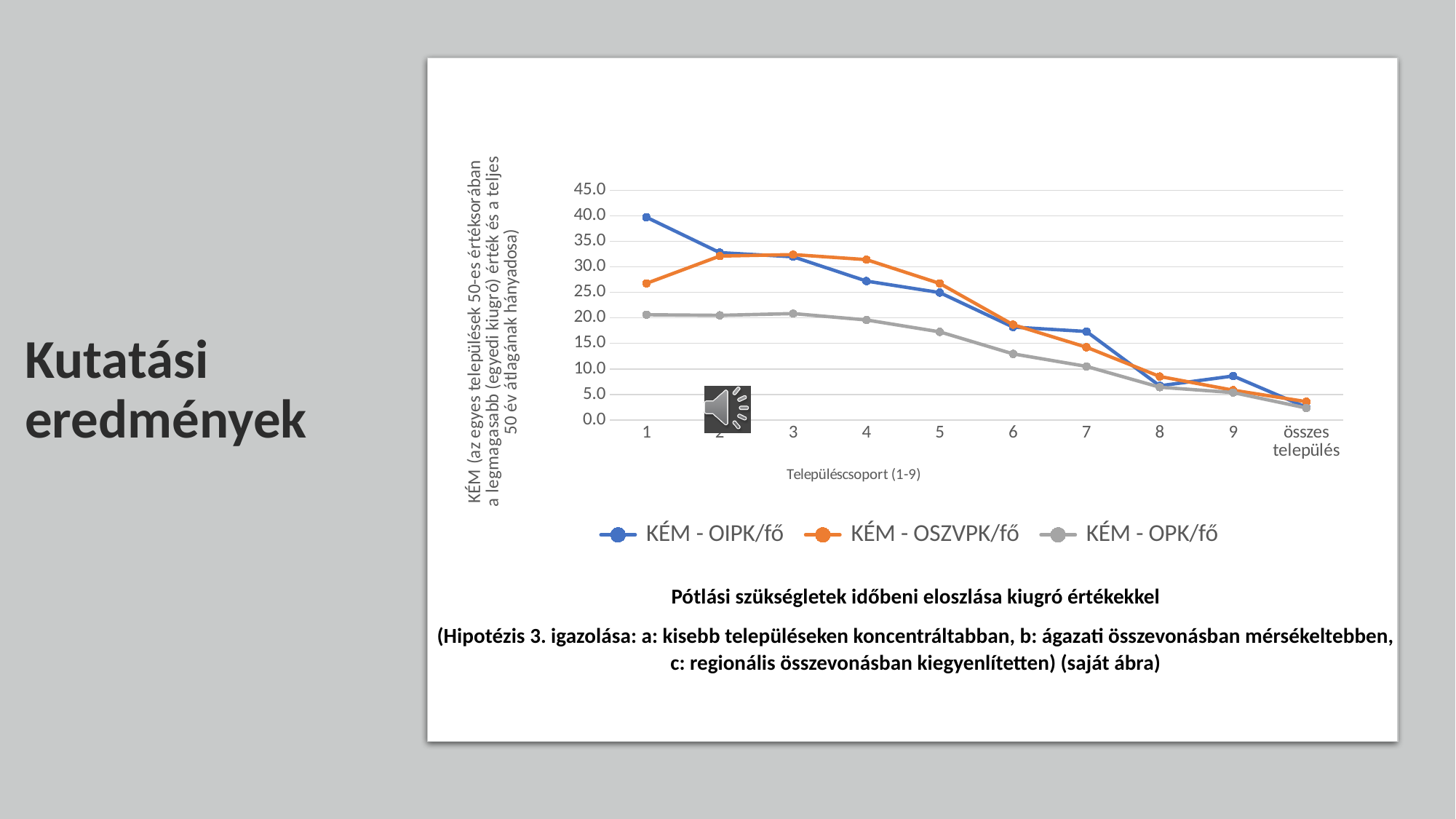
How many series does the legend list? 3 At category 1, which series has the larger value: KÉM - OIPK/fő or KÉM - OSZVPK/fő? KÉM - OIPK/fő What kind of chart is shown on the slide? line chart What is the title of the x axis of the chart? Településcsoport (1-9) Do the values of the KÉM - OIPK/fő series generally rise or fall from category 1 to összes település? fall Is the value for KÉM - OSZVPK/fő at category 1 greater or less than 30.0? less For which category is the KÉM - OPK/fő series lowest? összes település Is the value for KÉM - OPK/fő at category 5 greater or less than 20.0? less How many categories are shown along the x axis? 10 For which category is the KÉM - OIPK/fő series highest? 1 At category 4, which series has the larger value: KÉM - OSZVPK/fő or KÉM - OPK/fő? KÉM - OSZVPK/fő Is the value for KÉM - OIPK/fő at category 1 greater or less than 35.0? greater